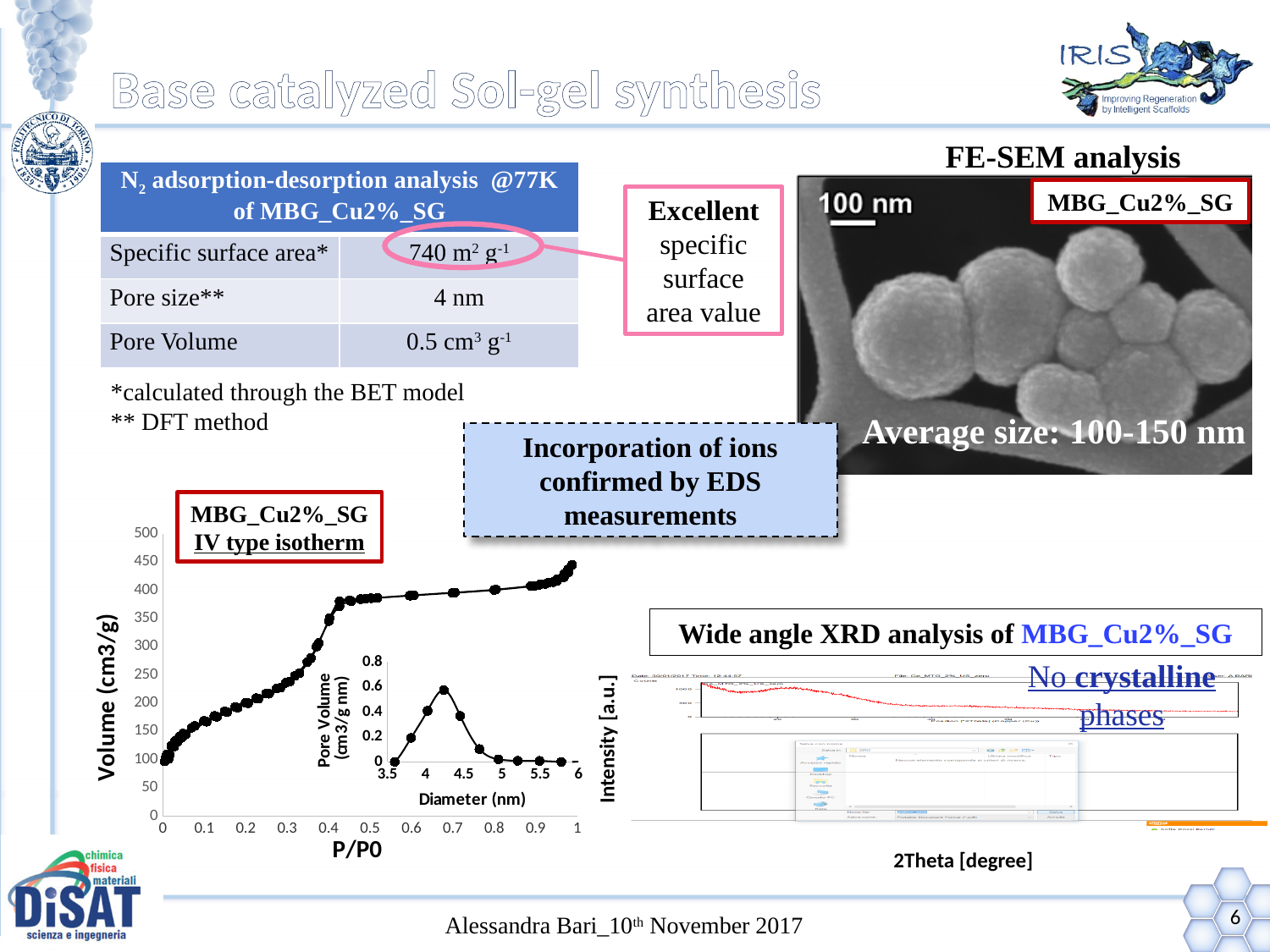
On the isotherm chart (bottom left), do the volume values rise or fall as P/P0 increases from 0 to 1? rise On the isotherm chart (bottom left), is the volume at P/P0 = 0.5 greater or less than 350? greater On the inset pore-size chart (Pore Volume vs Diameter), is the pore volume at a diameter of 5.5 nm greater or less than 0.2? less On the isotherm chart (bottom left), what is the label of the y axis? Volume (cm3/g) On the isotherm chart (bottom left), is the volume at the lowest P/P0 point (near 0) greater or less than 150? less On the inset pore-size chart, is the pore volume at a diameter of 4.5 nm larger or smaller than at 5.5 nm? larger What kind of chart is the isotherm chart on the bottom left? line chart What is the x-axis label of the XRD chart on the bottom right? 2Theta [degree] On the isotherm chart (bottom left), what is the label of the x axis? P/P0